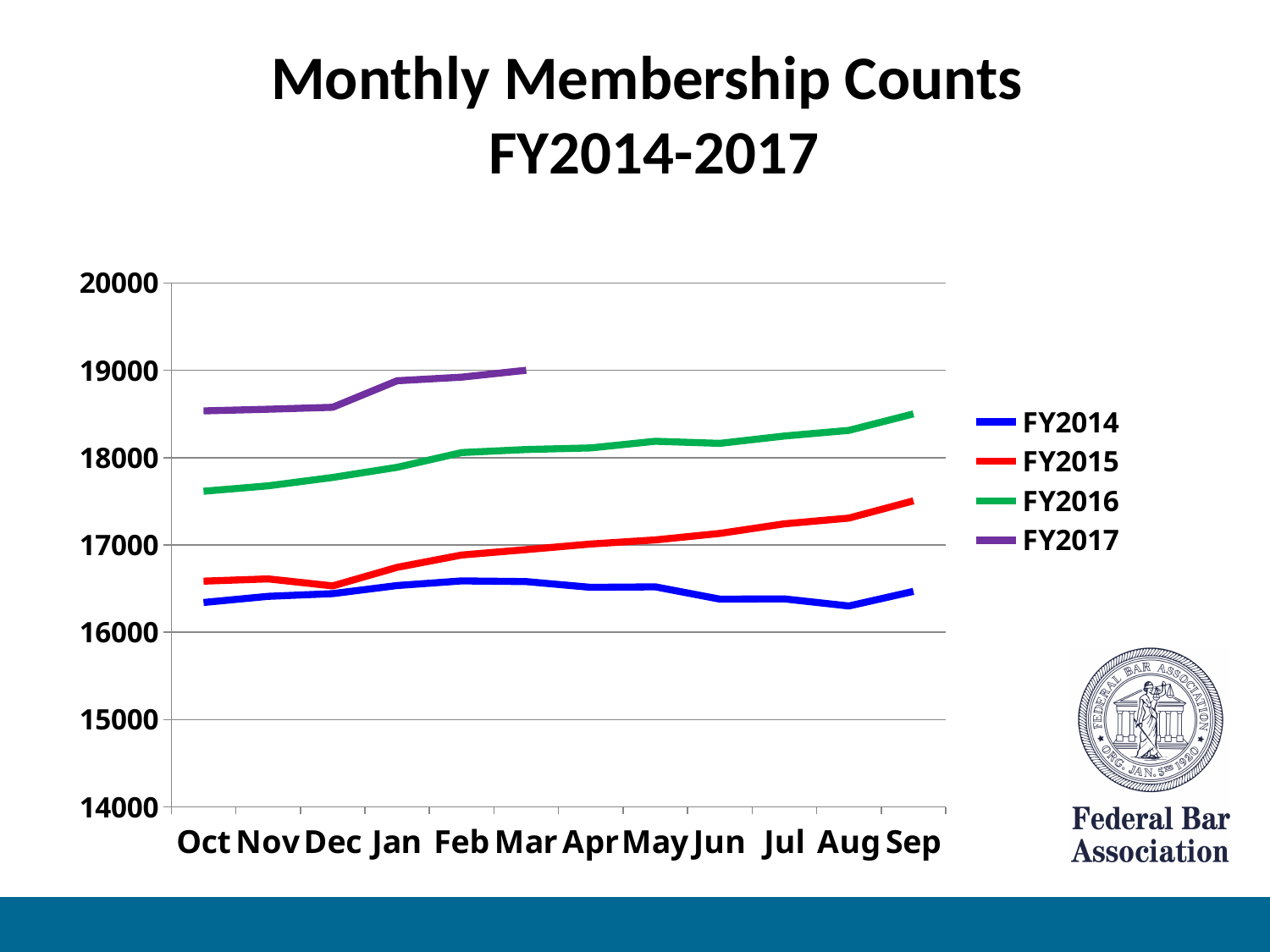
What is the title of the chart? Monthly Membership Counts FY2014-2017 Which fiscal year series has the lowest membership counts? FY2014 Do the FY2016 values generally rise or fall from Oct to Sep? rise Is the FY2015 value for Sep greater or less than 17000? greater Which is larger in Oct, the FY2016 value or the FY2014 value? FY2016 Is the FY2017 value for Oct greater or less than 18000? greater Which fiscal year series has the highest membership counts? FY2017 Is the FY2014 value for Sep greater or less than 17000? less How many months are shown along the x axis? 12 What kind of chart is shown on the slide? line chart How many series does the legend list? 4